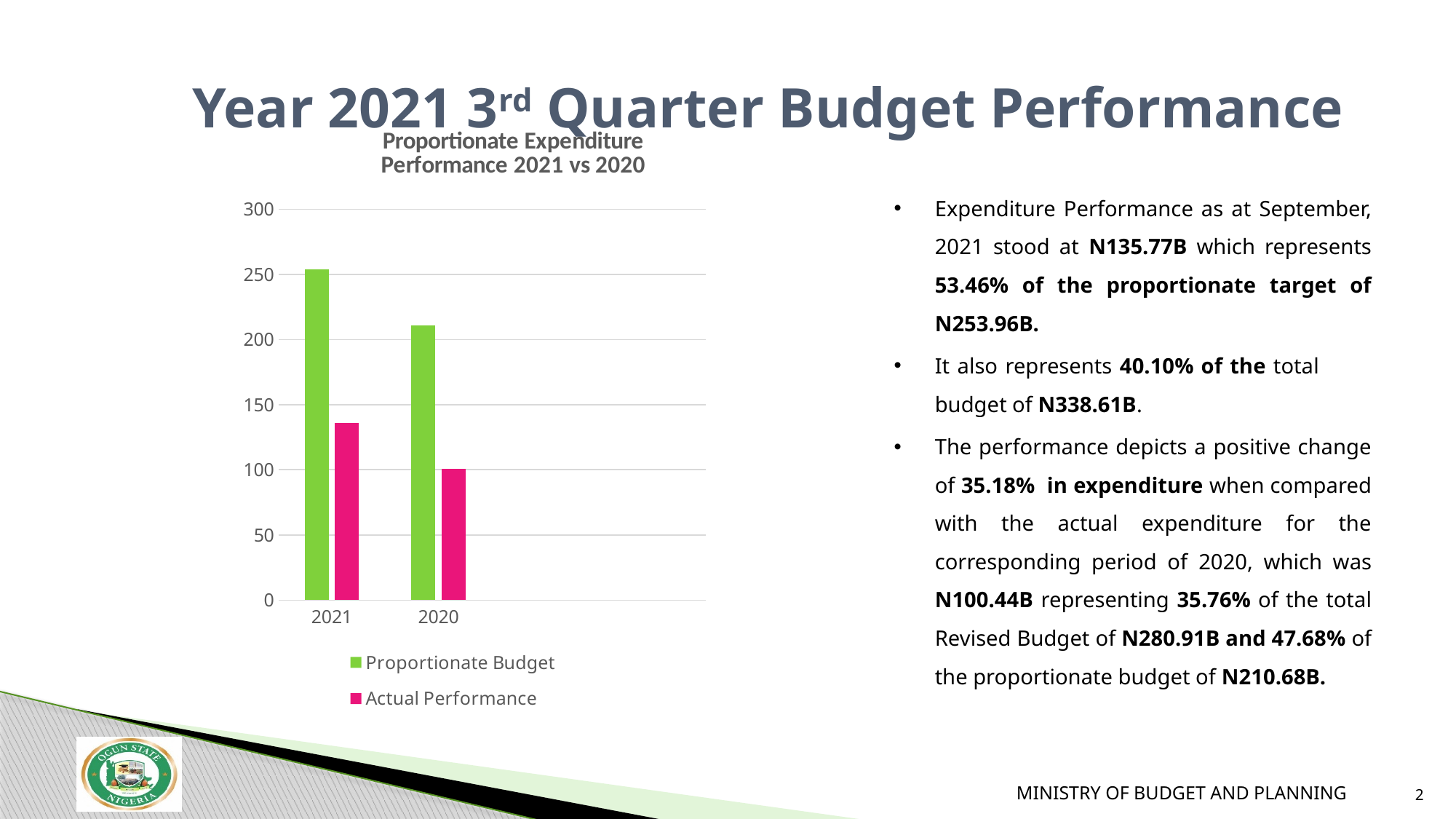
How many series does the chart legend list? 2 Does the Proportionate Budget rise or fall from 2021 to 2020 along the x axis? Fall Which series is shown in green in the chart? Proportionate Budget How many categories are shown on the x axis of the chart? 2 What is the title of the chart? Proportionate Expenditure Performance 2021 vs 2020 Which bar in the chart is the highest? Proportionate Budget for 2021 What kind of chart is shown on the slide? Bar chart Is the Proportionate Budget value for 2021 greater or less than 200? greater Is the Actual Performance value for 2021 greater or less than 150? less Is the Proportionate Budget value for 2020 greater or less than 250? less Which is larger, the Actual Performance for 2021 or the Actual Performance for 2020? Actual Performance for 2021 Which bar in the chart is the lowest? Actual Performance for 2020